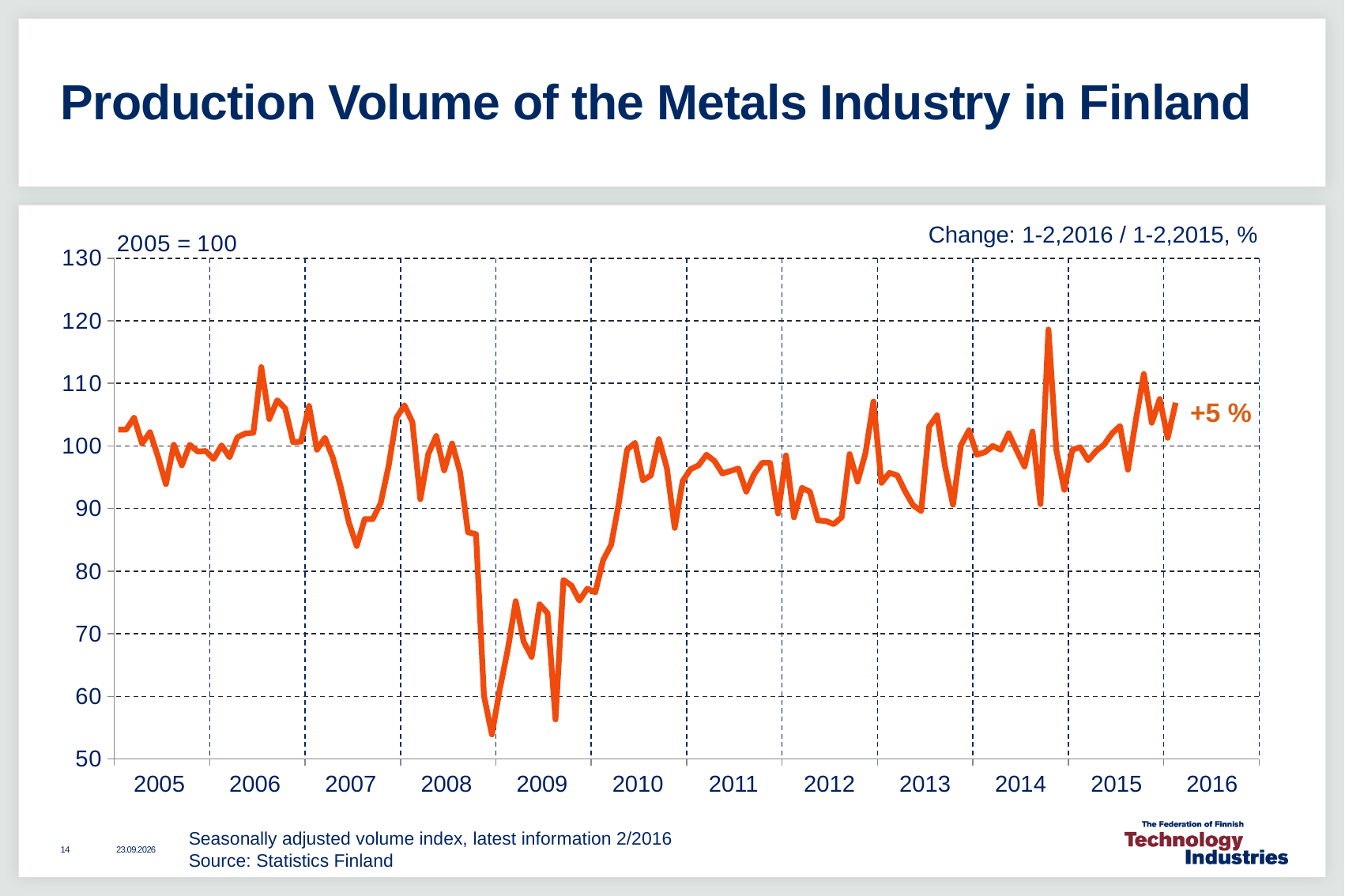
Does the index rise or fall between the start of 2008 and the end of 2008? fall In which year does the line reach its lowest point? 2008 Is the highest peak of the index, reached in 2014, greater or less than 110? greater Does the index rise or fall from the start of 2009 to the start of 2010? rise What percentage change for 1-2,2016 / 1-2,2015 is printed next to the end of the line? +5 % What kind of chart is shown on the slide? line chart How many years are labelled along the x axis? 12 Is the lowest value of the index, reached in 2008, greater or less than 60? less What is the title of the chart on the slide? Production Volume of the Metals Industry in Finland In which year does the line reach its highest peak? 2014 What base year and value is the index set to, as noted above the chart? 2005 = 100 Is the index value at the start of 2005 greater or less than 100? greater